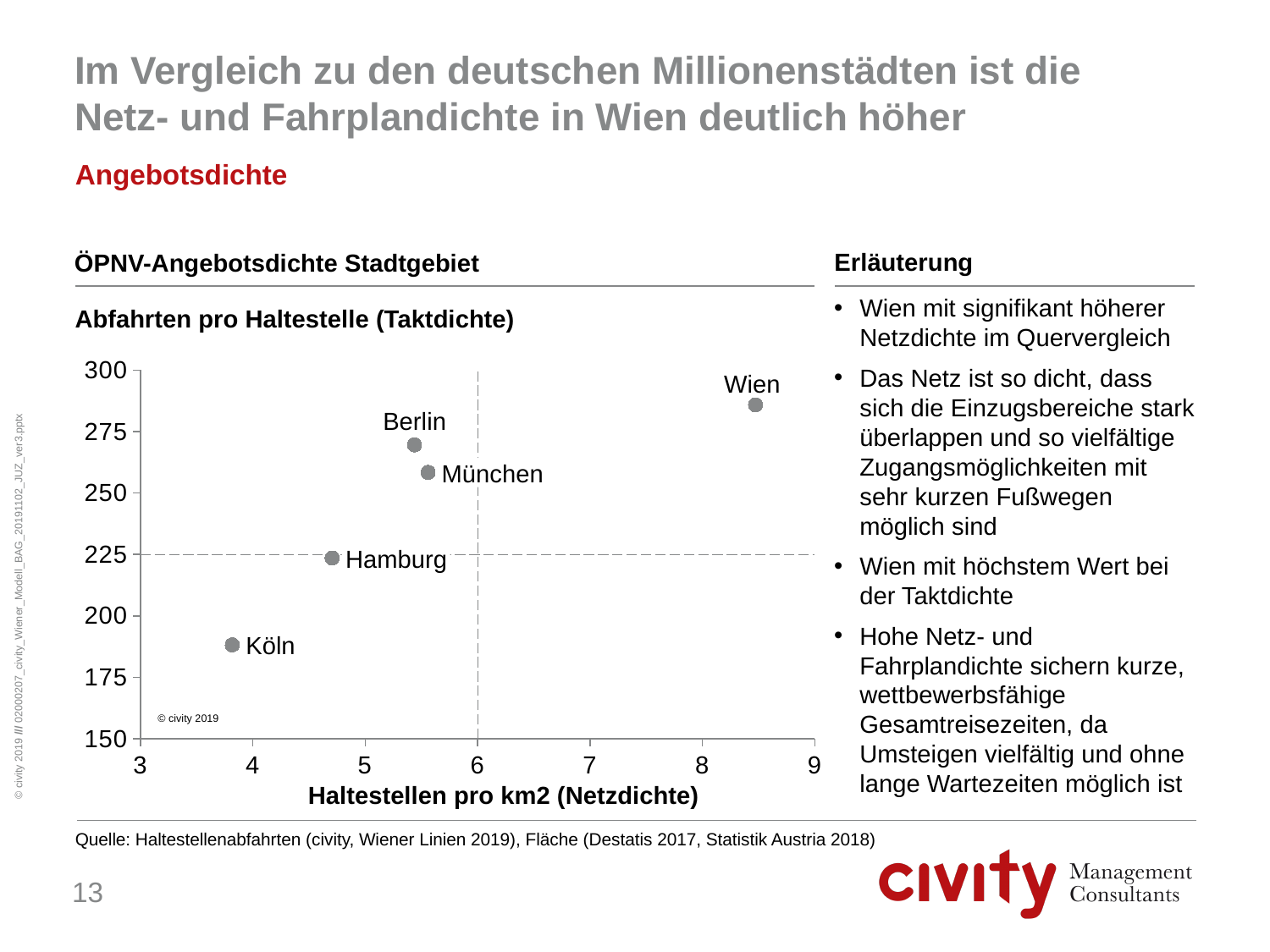
Which city has the highest value for Haltestellen pro km2 (Netzdichte)? Wien Is the Haltestellen pro km2 value for Wien greater or less than 8? greater Is the Abfahrten pro Haltestelle value for Wien greater or less than 275? greater Which city has the higher Abfahrten pro Haltestelle value, Berlin or München? Berlin How many cities are plotted in the chart? 5 Which city has the lowest value for Abfahrten pro Haltestelle (Taktdichte)? Köln What kind of chart is shown under "ÖPNV-Angebotsdichte Stadtgebiet"? scatter chart What is the label of the horizontal axis of the chart? Haltestellen pro km2 (Netzdichte) Which city has the highest value for Abfahrten pro Haltestelle (Taktdichte)? Wien Which city has the lowest value for Haltestellen pro km2 (Netzdichte)? Köln Is the Haltestellen pro km2 value for Hamburg greater or less than 5? less